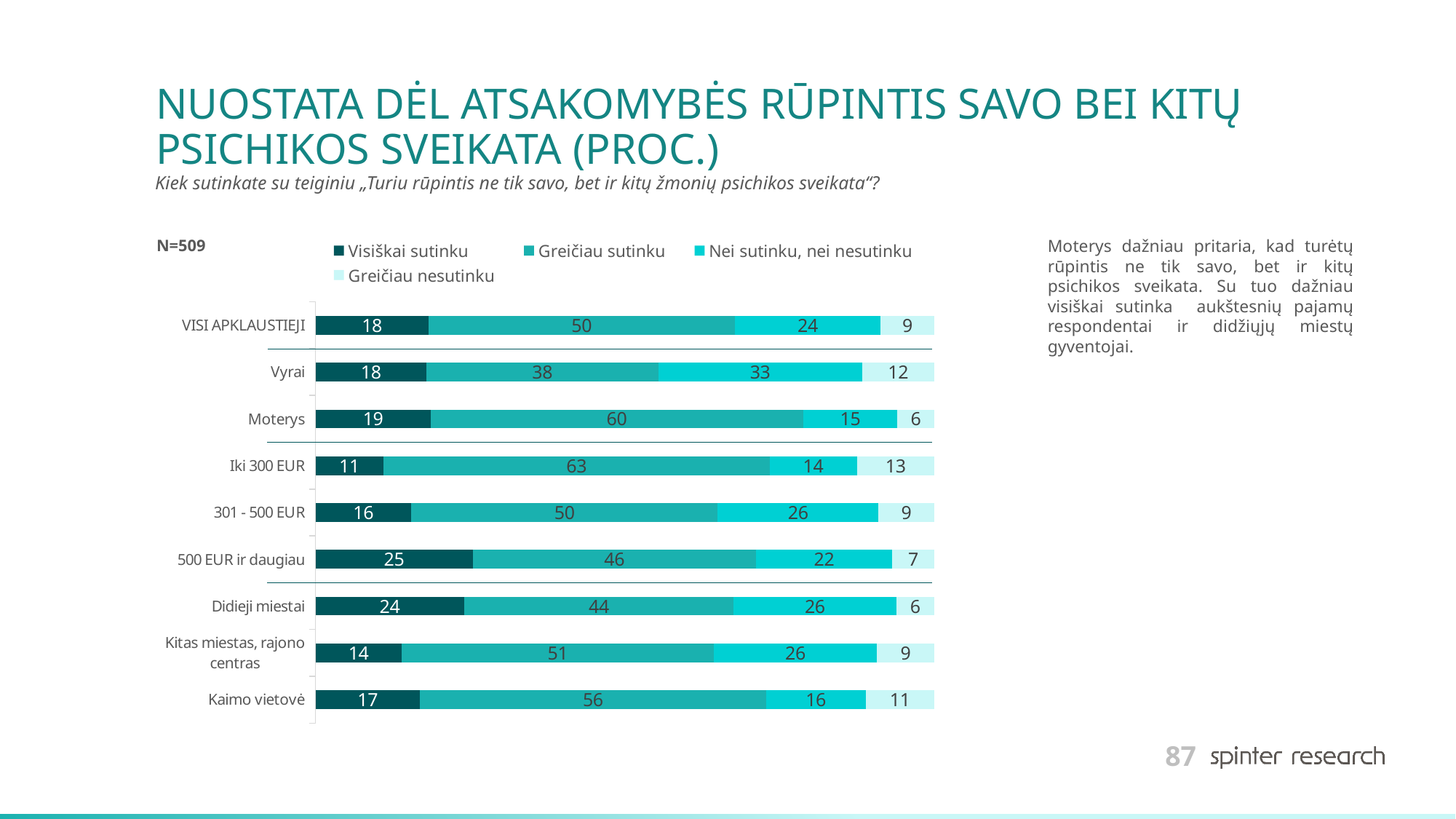
How many categories are shown on the chart? 9 What is the difference between the "Greičiau sutinku" values for Moterys and Vyrai? 22 What is the value of "Visiškai sutinku" for Moterys? 19 Which category has the lowest "Visiškai sutinku" value? Iki 300 EUR Which has a larger "Nei sutinku, nei nesutinku" value, Didieji miestai or Kaimo vietovė? Didieji miestai What is the total of the stacked bar for Vyrai? 101 What kind of chart is shown on the slide? Stacked bar chart Which category has the highest "Visiškai sutinku" value? 500 EUR ir daugiau What is the value of "Nei sutinku, nei nesutinku" for Vyrai? 33 How many series does the legend list? 4 What is the value of "Greičiau nesutinku" for Kaimo vietovė? 11 What is the value of "Greičiau sutinku" for Iki 300 EUR? 63